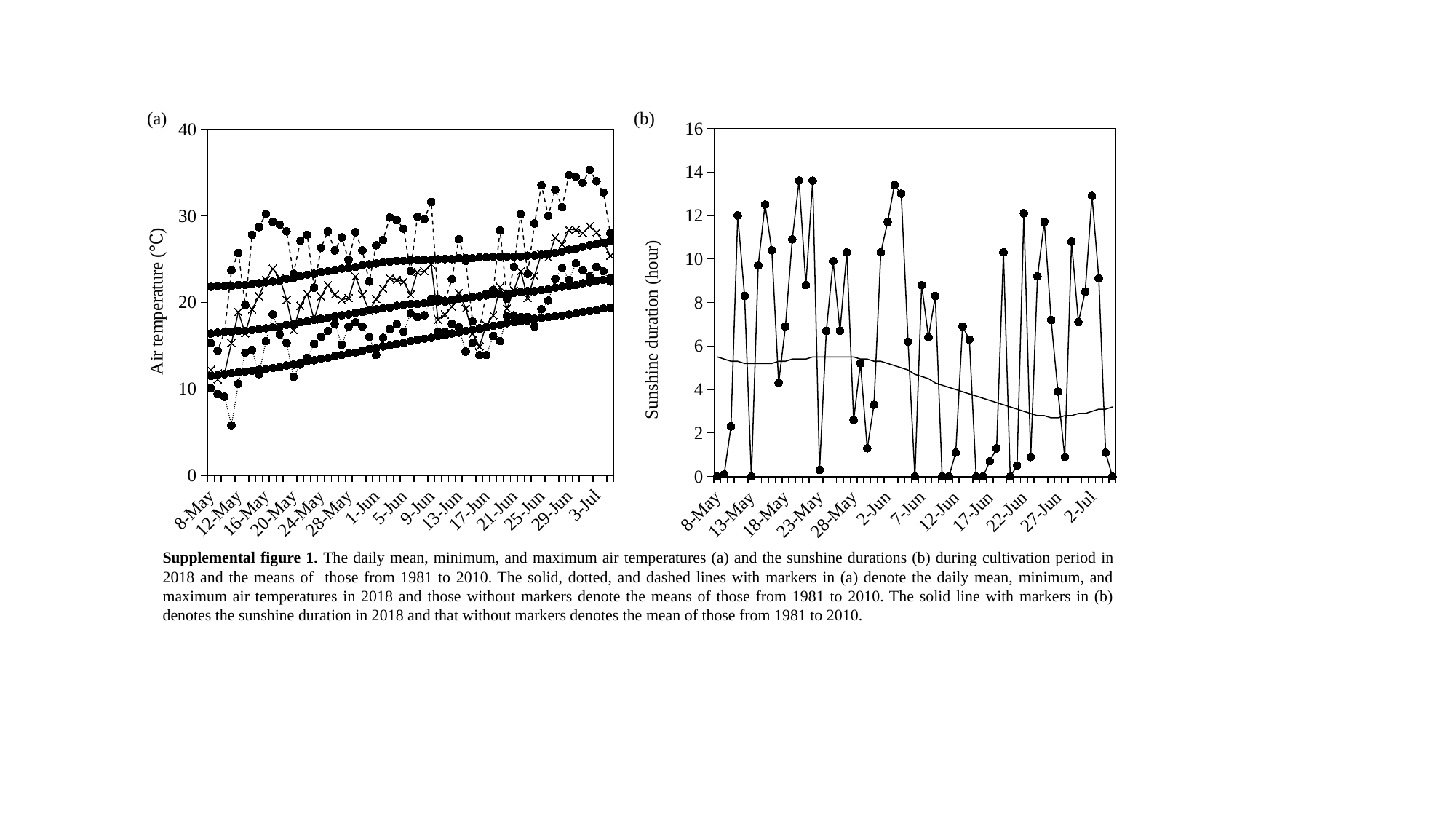
In chart (a), what is the label of the vertical axis? Air temperature (°C) In chart (a), is the 1981–2010 mean minimum air temperature at 8-May greater or less than 20? less What kind of chart is chart (b) on the right? Line chart In chart (a), is the 1981–2010 mean maximum air temperature at 8-May greater or less than 20? greater How many date labels are shown on the x axis of chart (b)? 12 In chart (b), is the highest sunshine duration in 2018 greater or less than 14? less What kind of chart is chart (a) on the left? Line chart In chart (a), do the 1981–2010 mean temperature lines (without markers) rise or fall from 8-May to 3-Jul? Rise In chart (b), does the 1981–2010 mean sunshine duration line (without markers) rise or fall from 8-May to 2-Jul? Fall How many date labels are shown on the x axis of chart (a)? 15 In chart (b), what is the label of the vertical axis? Sunshine duration (hour)